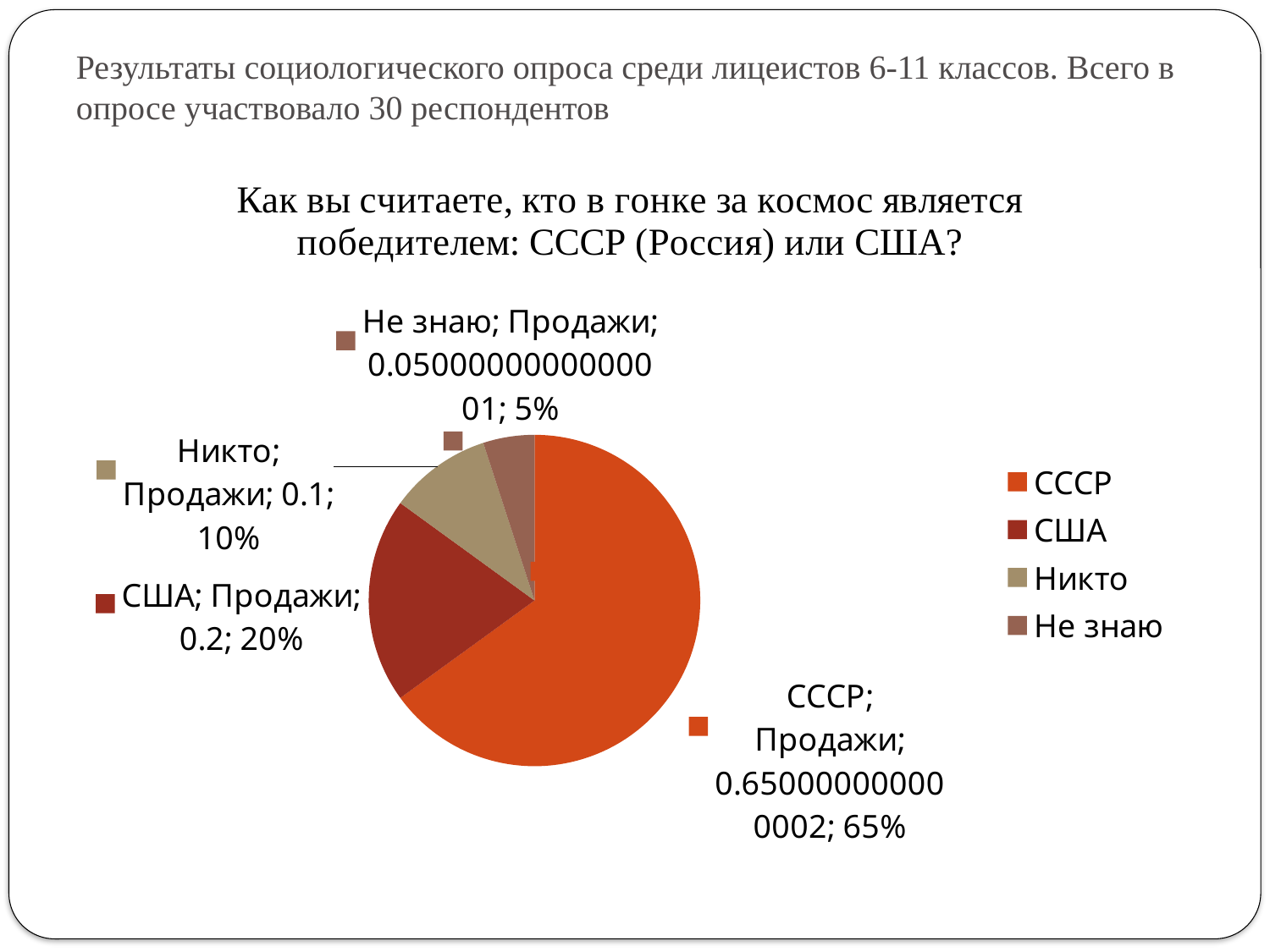
Which slice is larger, США or Никто? США What percentage share does the СССР slice have? 65% What percentage share does the Не знаю slice have? 5% What percentage share does the Никто slice have? 10% What is the difference in percentage points between the СССР share and the США share? 45% Which category has the smallest slice of the pie? Не знаю How many entries does the legend list? 4 Which category has the largest slice of the pie? СССР What is the title of the chart? Как вы считаете, кто в гонке за космос является победителем: СССР (Россия) или США? What kind of chart is shown on the slide? pie chart How many categories (slices) does the pie chart have? 4